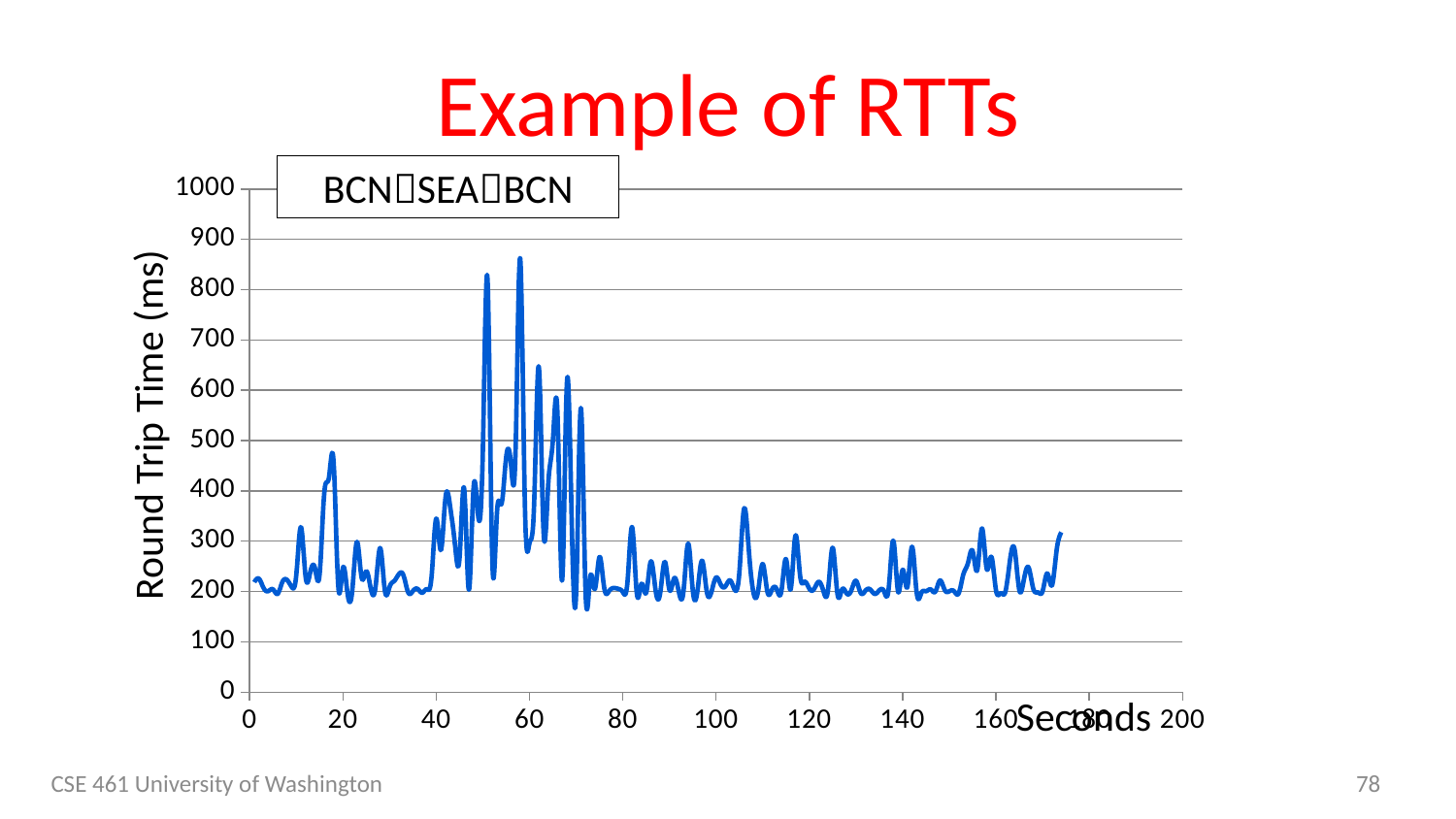
Is the highest round trip time on the chart greater or less than 800? greater How many data series are plotted on the chart? 1 Is the round trip time at 0 seconds greater or less than 300? less Is the round trip time at 140 seconds greater or less than 600? less What is the highest value shown on the vertical axis? 1000 What kind of chart is shown on the slide? line chart What is the title of the slide's chart? Example of RTTs Is the round trip time higher around 58 seconds or around 120 seconds? around 58 seconds What is the label on the vertical axis of the chart? Round Trip Time (ms)